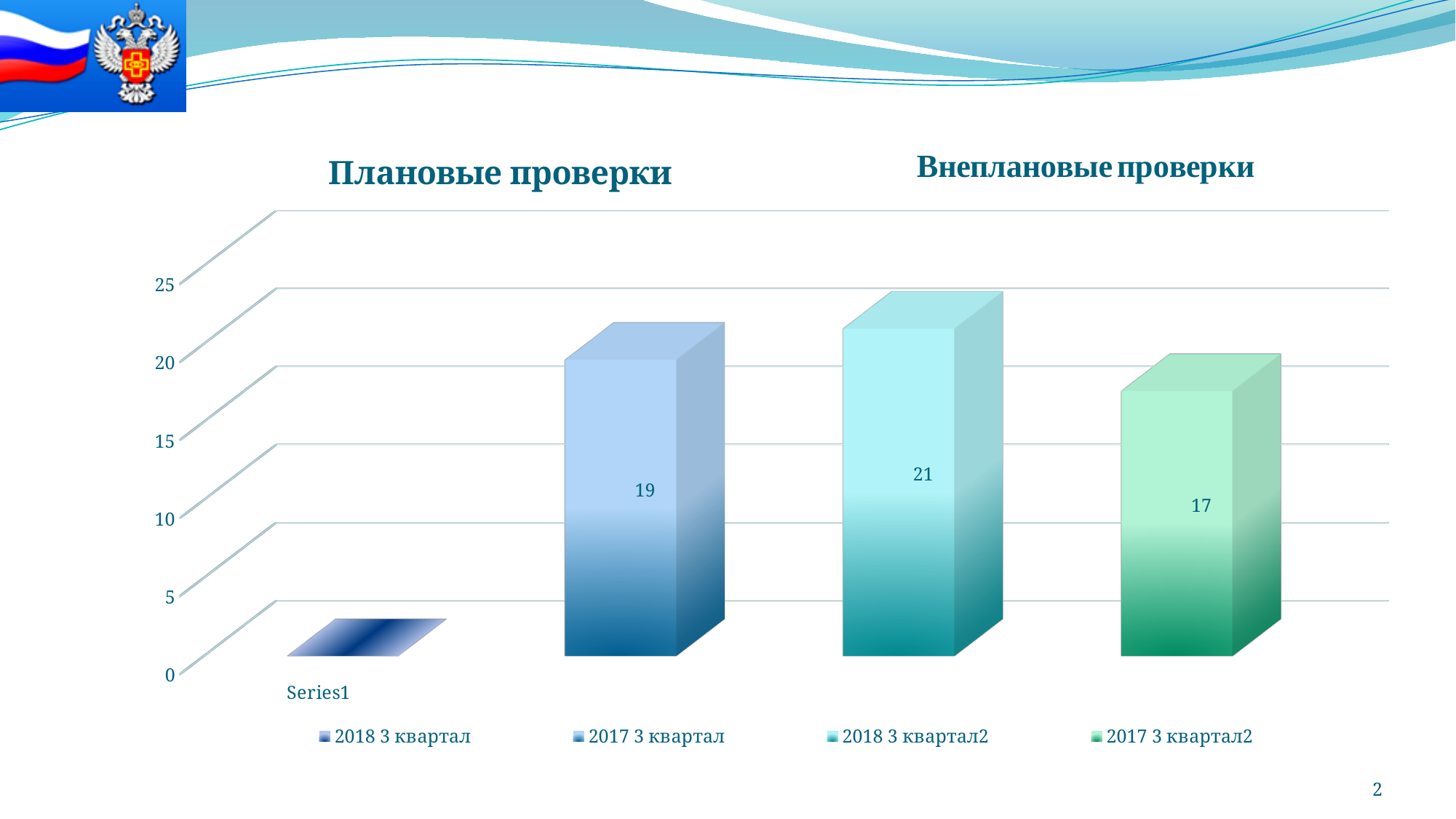
Which is larger, the value for "2017 3 квартал" or the value for "2017 3 квартал2"? 2017 3 квартал What kind of chart is shown on the slide? bar chart What is the label shown on the category axis of the chart? Series1 What is the difference between the values for "2018 3 квартал2" and "2017 3 квартал2"? 4 What is the value of the bar for the series "2018 3 квартал2"? 21 Is the value for "2018 3 квартал" greater or less than 5? less What is the value of the bar for the series "2017 3 квартал2"? 17 What is the difference between the values for "2018 3 квартал2" and "2017 3 квартал"? 2 Which series has the highest bar on the chart? 2018 3 квартал2 What is the value of the bar for the series "2017 3 квартал"? 19 Which series has the lowest bar on the chart? 2018 3 квартал How many series does the legend list? 4